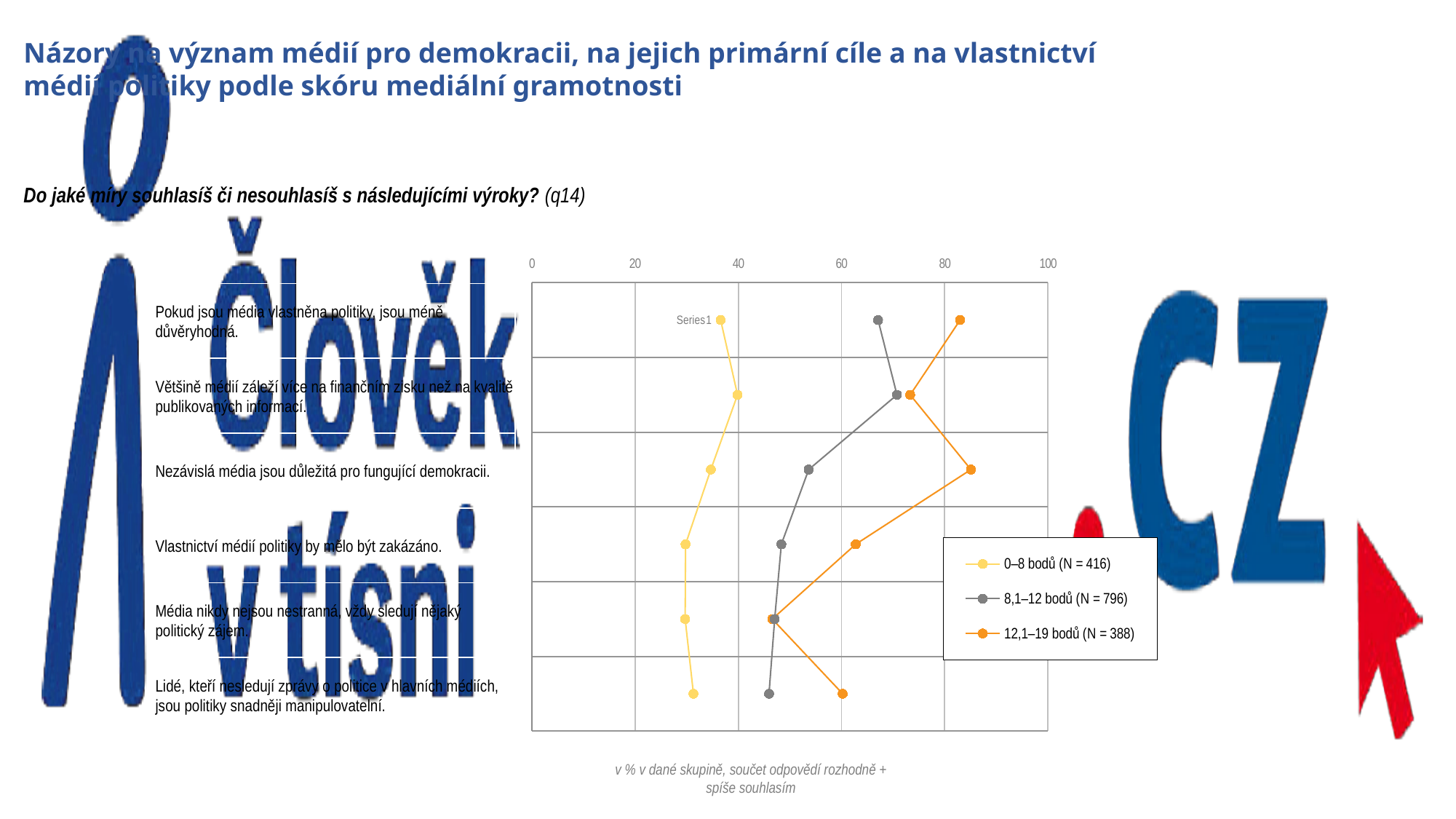
Is the value for the 12,1–19 bodů group on 'Nezávislá média jsou důležitá pro fungující demokracii.' greater or less than 80? greater Is the value for the 0–8 bodů group on 'Vlastnictví médií politiky by mělo být zakázáno.' greater or less than 40? less How many statements (categories) are plotted on the chart? 6 Is the value for the 8,1–12 bodů group on 'Nezávislá média jsou důležitá pro fungující demokracii.' greater or less than 40? greater What kind of chart is shown on the slide? line chart What is the highest value shown on the horizontal axis? 100 For 'Pokud jsou média vlastněna politiky, jsou méně důvěryhodná.', which group has the larger value: 0–8 bodů or 12,1–19 bodů? 12,1–19 bodů How many series does the legend list? 3 Which legend entry has N = 796? 8,1–12 bodů For 'Lidé, kteří nesledují zprávy o politice v hlavních médiích, jsou politiky snadněji manipulovatelní.', which group has the larger value: 0–8 bodů or 8,1–12 bodů? 8,1–12 bodů